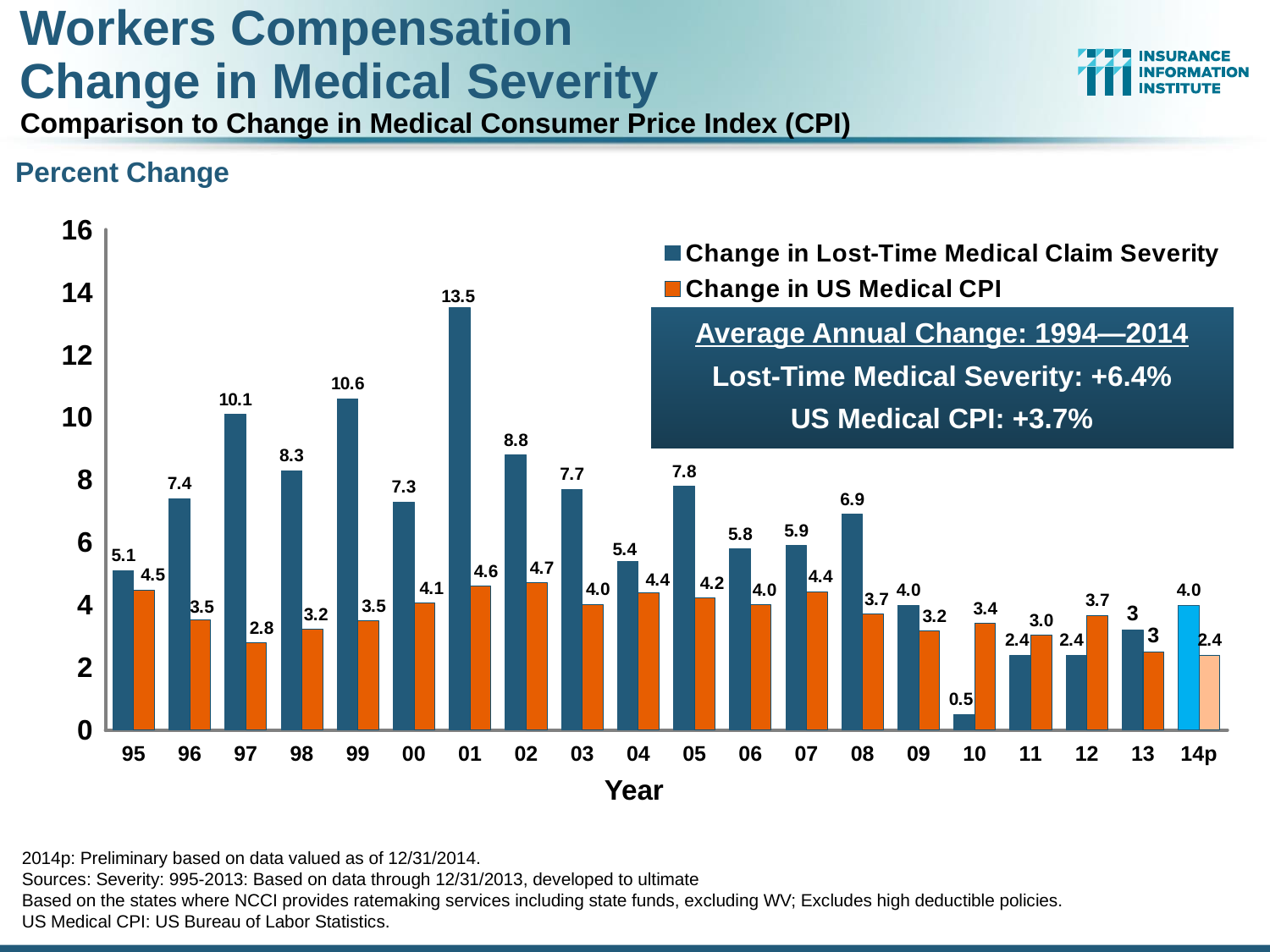
What is the Change in US Medical CPI for 02? 4.7 What is the Change in Lost-Time Medical Claim Severity for 14p? 4.0 How many years are shown on the x axis? 20 What kind of chart is shown on the slide? Bar chart How many series does the legend list? 2 Which year has the lowest Change in Lost-Time Medical Claim Severity? 10 What is the Change in Lost-Time Medical Claim Severity for 01? 13.5 What is the difference between the Change in Lost-Time Medical Claim Severity and the Change in US Medical CPI in 01? 8.9 In 10, which is larger: the Change in Lost-Time Medical Claim Severity or the Change in US Medical CPI? Change in US Medical CPI Does the Change in Lost-Time Medical Claim Severity rise or fall from 08 to 10? Fall According to the text box on the chart, what is the average annual change in US Medical CPI for 1994—2014? +3.7% Which year has the highest Change in Lost-Time Medical Claim Severity? 01